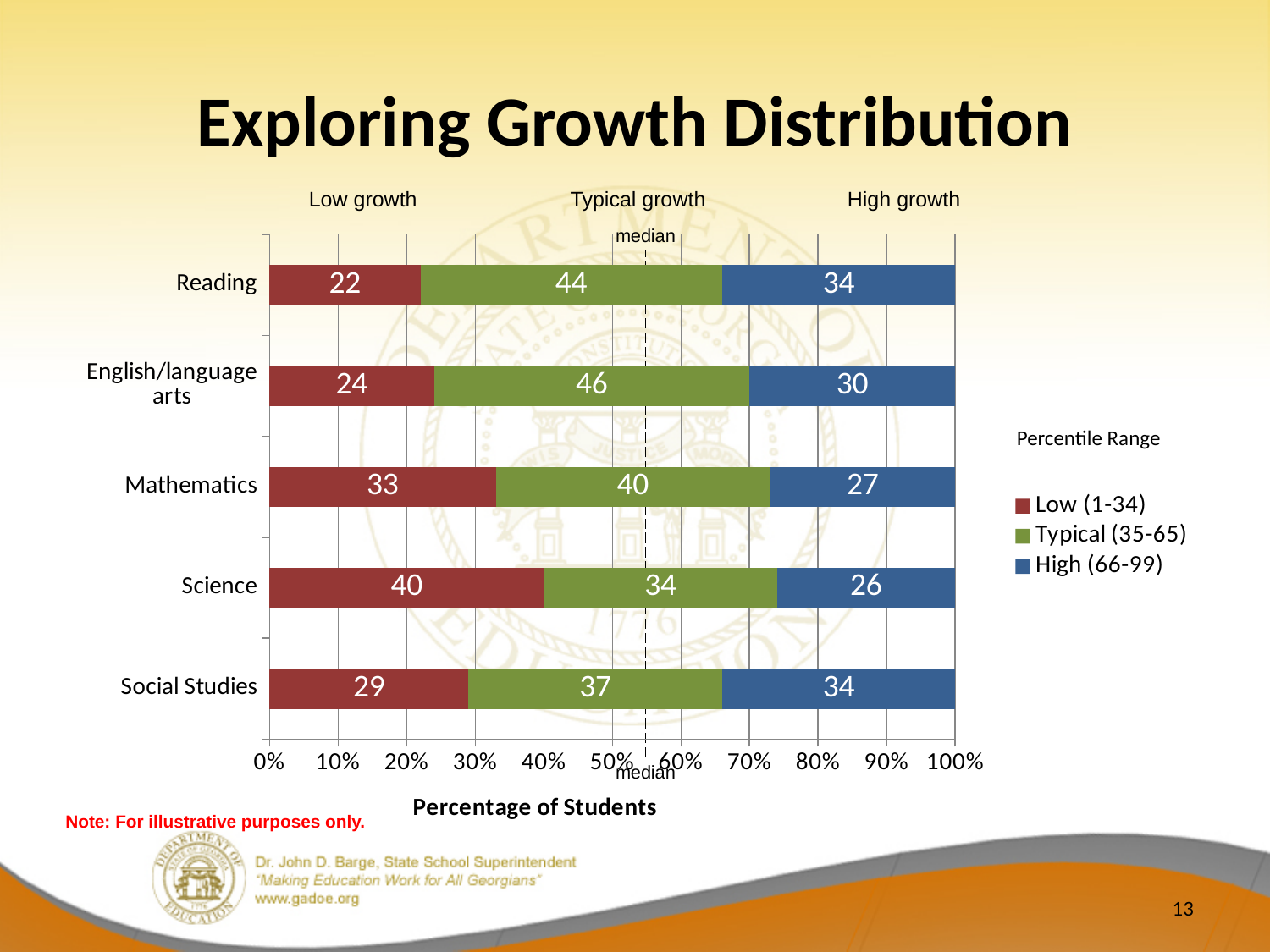
Which subject has the highest Low (1-34) value? Science How many series does the legend list? 3 What is the Typical (35-65) value for English/language arts? 46 What is the Low (1-34) value for Reading? 22 What is the title of the x axis? Percentage of Students How many subjects are shown on the chart? 5 Which subject has the lowest High (66-99) value? Science What is the difference between the Typical (35-65) values for Reading and Social Studies? 7 What kind of chart is shown on the slide? Stacked bar chart What is the total of the stacked bar for Science? 100 What is the High (66-99) value for Mathematics? 27 Which is larger, the Low (1-34) value for Mathematics or the Low (1-34) value for Social Studies? Mathematics